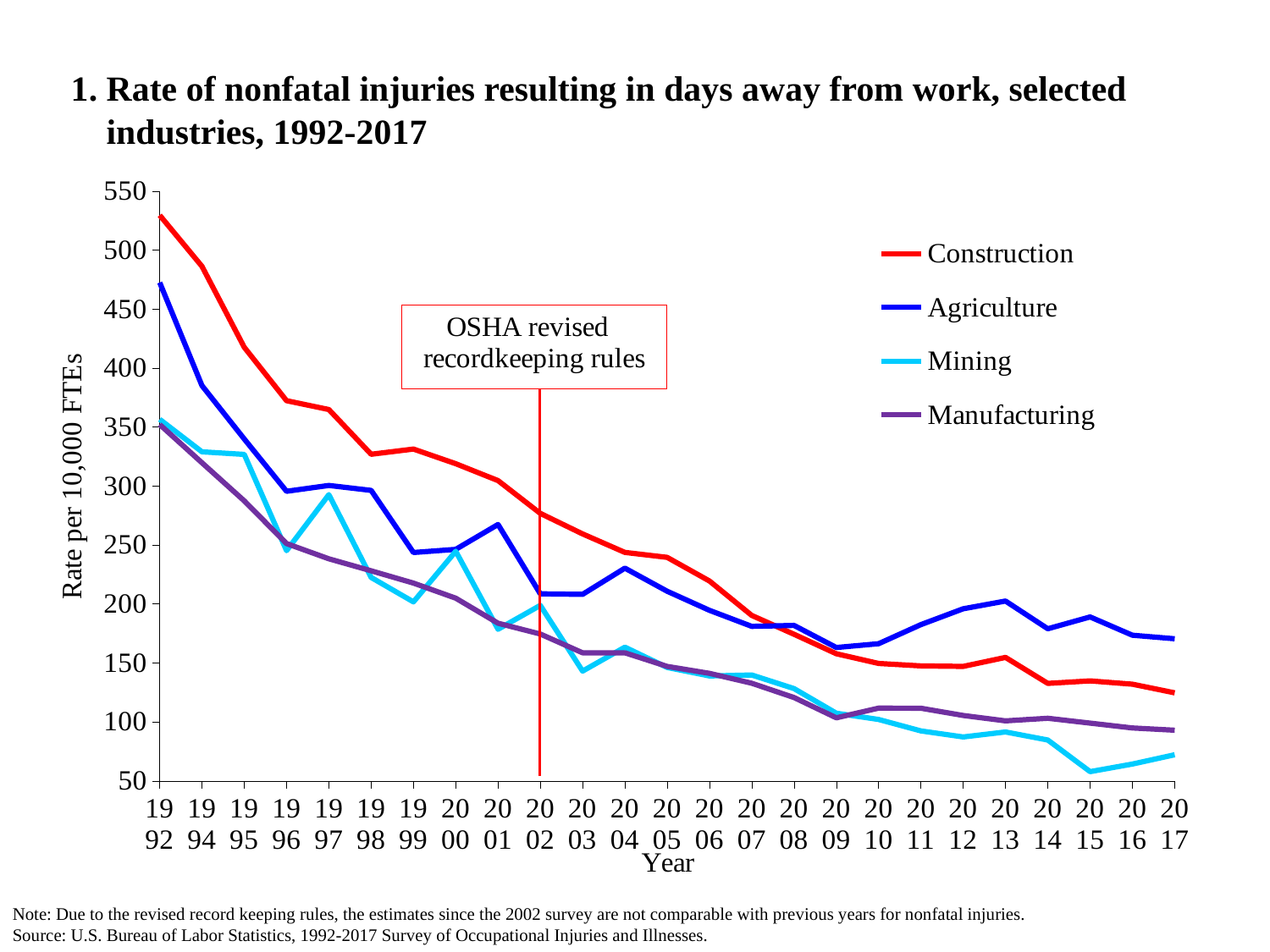
Which industry had the lowest injury rate in 2017? Mining Is the Construction rate in 1992 greater or less than 500? greater What event does the vertical red line in the chart mark? OSHA revised recordkeeping rules Does the Construction injury rate generally rise or fall from 1992 to 2017? Fall Is the Mining rate in 2015 greater or less than 100? less How many years are plotted along the x axis? 25 In 2017, which is higher: the Agriculture rate or the Construction rate? Agriculture How many series does the legend list? 4 Which industry had the highest injury rate in 1992? Construction In 1992, which is higher: the Construction rate or the Agriculture rate? Construction What kind of chart is shown on the slide? Line chart Is the Agriculture rate in 2017 greater or less than 200? less